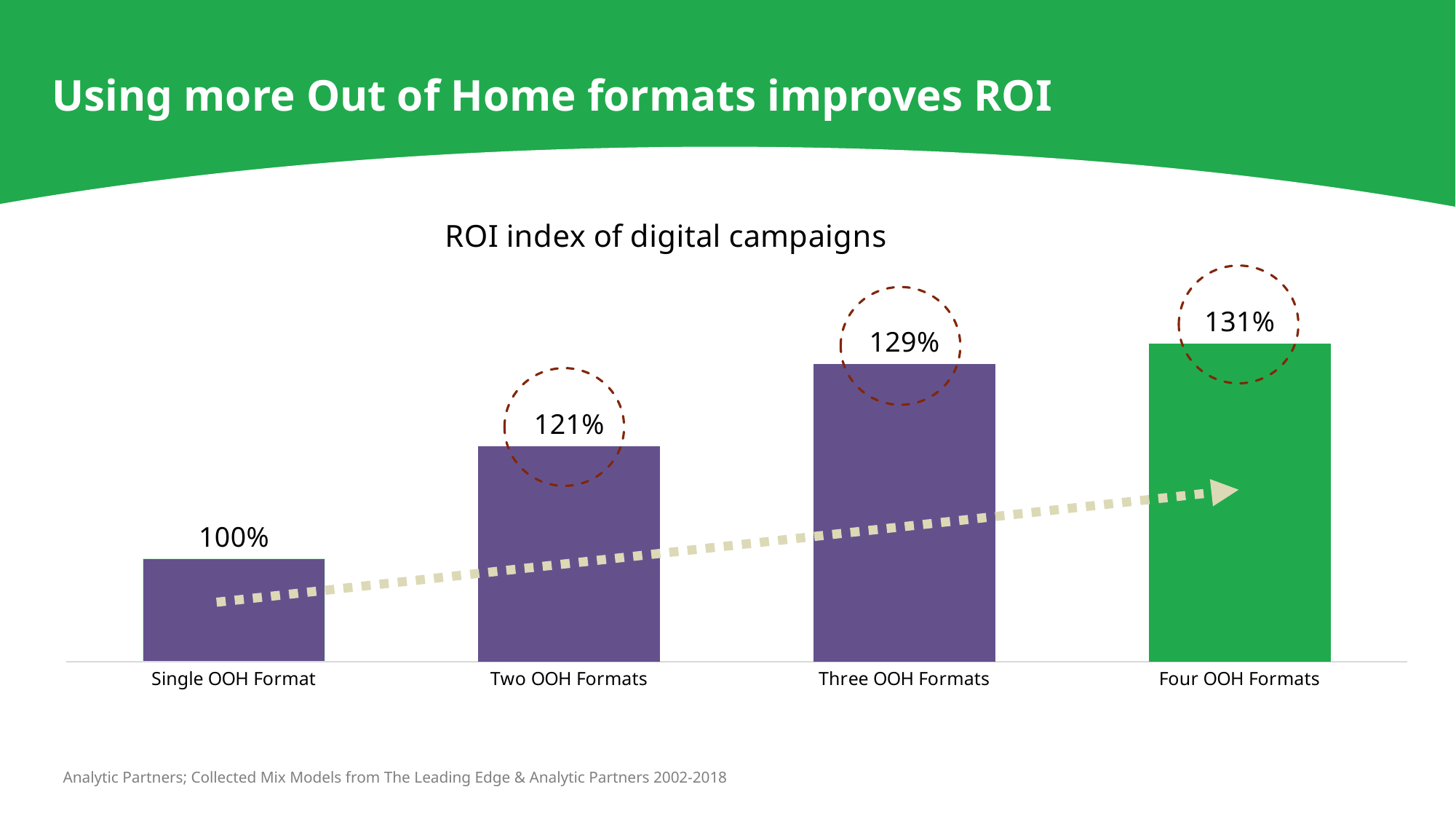
How many categories are shown in the chart? 4 What is the difference between the ROI index for Three OOH Formats and Two OOH Formats? 8% What is the ROI index value for Three OOH Formats? 129% Which category has the lowest ROI index? Single OOH Format What is the ROI index value for Two OOH Formats? 121% What is the ROI index value for Single OOH Format? 100% Which has a higher ROI index, Two OOH Formats or Three OOH Formats? Three OOH Formats What is the difference between the ROI index for Four OOH Formats and Single OOH Format? 31% What kind of chart is shown on the slide? Bar chart What is the ROI index value for Four OOH Formats? 131% Which category has the highest ROI index? Four OOH Formats Do the ROI index values rise or fall as the number of OOH formats increases? Rise